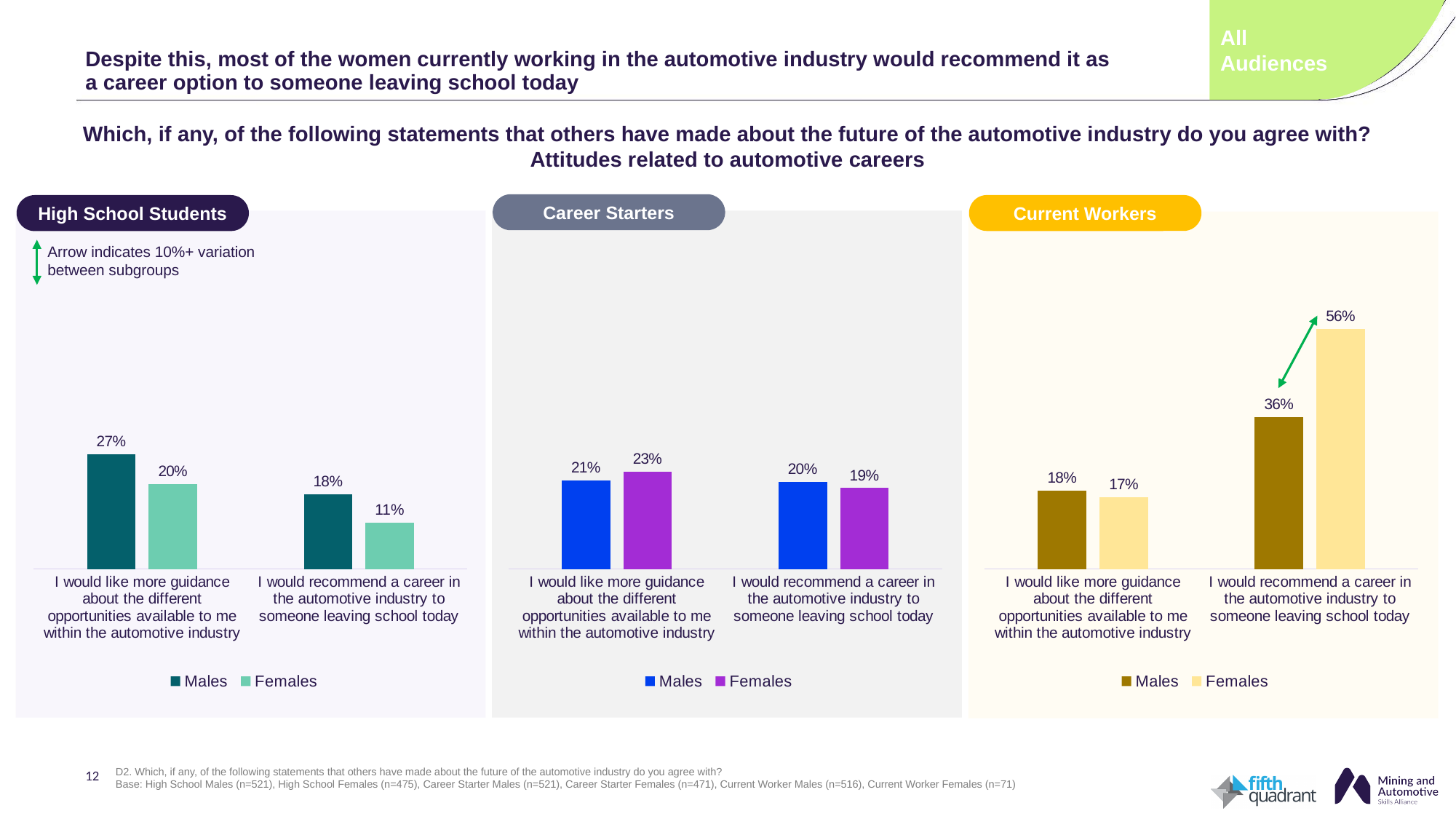
In the Current Workers chart, what percentage of females would recommend a career in the automotive industry to someone leaving school today? 56% In the Current Workers chart, what is the difference between females and males for recommending a career in the automotive industry? 20% In the High School Students chart, which bar has the lowest value? Females, recommend a career (11%) How many series does the legend of the Current Workers chart list? 2 Across all three charts, which bar has the highest value? Current Workers Females, recommend a career (56%) In the High School Students chart, what percentage of males would like more guidance about the different opportunities available within the automotive industry? 27% In the Current Workers chart, what does the green arrow between the 36% and 56% bars indicate? 10%+ variation between subgroups What type of chart is used in the Career Starters panel? Bar chart In the Career Starters chart, which is larger for recommending a career in the automotive industry: males or females? Males In the High School Students chart, what is the difference between males and females for wanting more guidance about opportunities in the automotive industry? 7% In the Career Starters chart, what percentage of females would like more guidance about the different opportunities available within the automotive industry? 23% In the High School Students chart, what percentage of females would recommend a career in the automotive industry to someone leaving school today? 11%